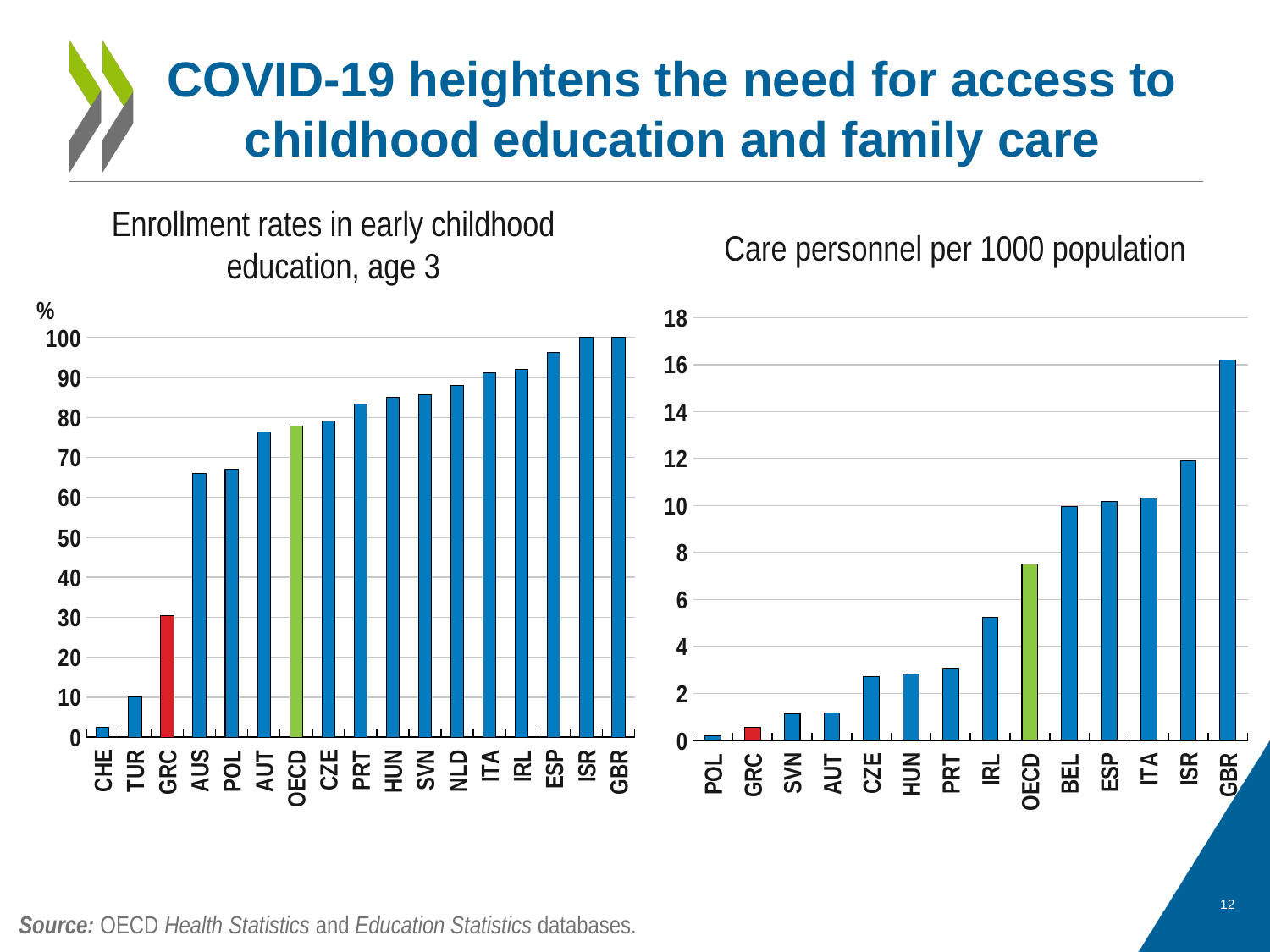
On the 'Enrollment rates in early childhood education, age 3' chart, which category has the lowest value? CHE On the 'Care personnel per 1000 population' chart, is the value for GBR greater or less than 14? greater How many categories are shown on the 'Enrollment rates in early childhood education, age 3' chart? 17 On the 'Care personnel per 1000 population' chart, which category has the lowest value? POL On the 'Care personnel per 1000 population' chart, do the values rise or fall from left to right along the x axis? rise On the 'Enrollment rates in early childhood education, age 3' chart, which is larger, GRC or AUS? AUS On the 'Enrollment rates in early childhood education, age 3' chart, is the value for OECD greater or less than 70? greater On the 'Enrollment rates in early childhood education, age 3' chart, is the value for GRC greater or less than 40? less How many countries/categories are shown on the 'Care personnel per 1000 population' chart? 14 What kind of chart is the 'Enrollment rates in early childhood education, age 3' chart? bar chart On the 'Care personnel per 1000 population' chart, which category has the highest value? GBR